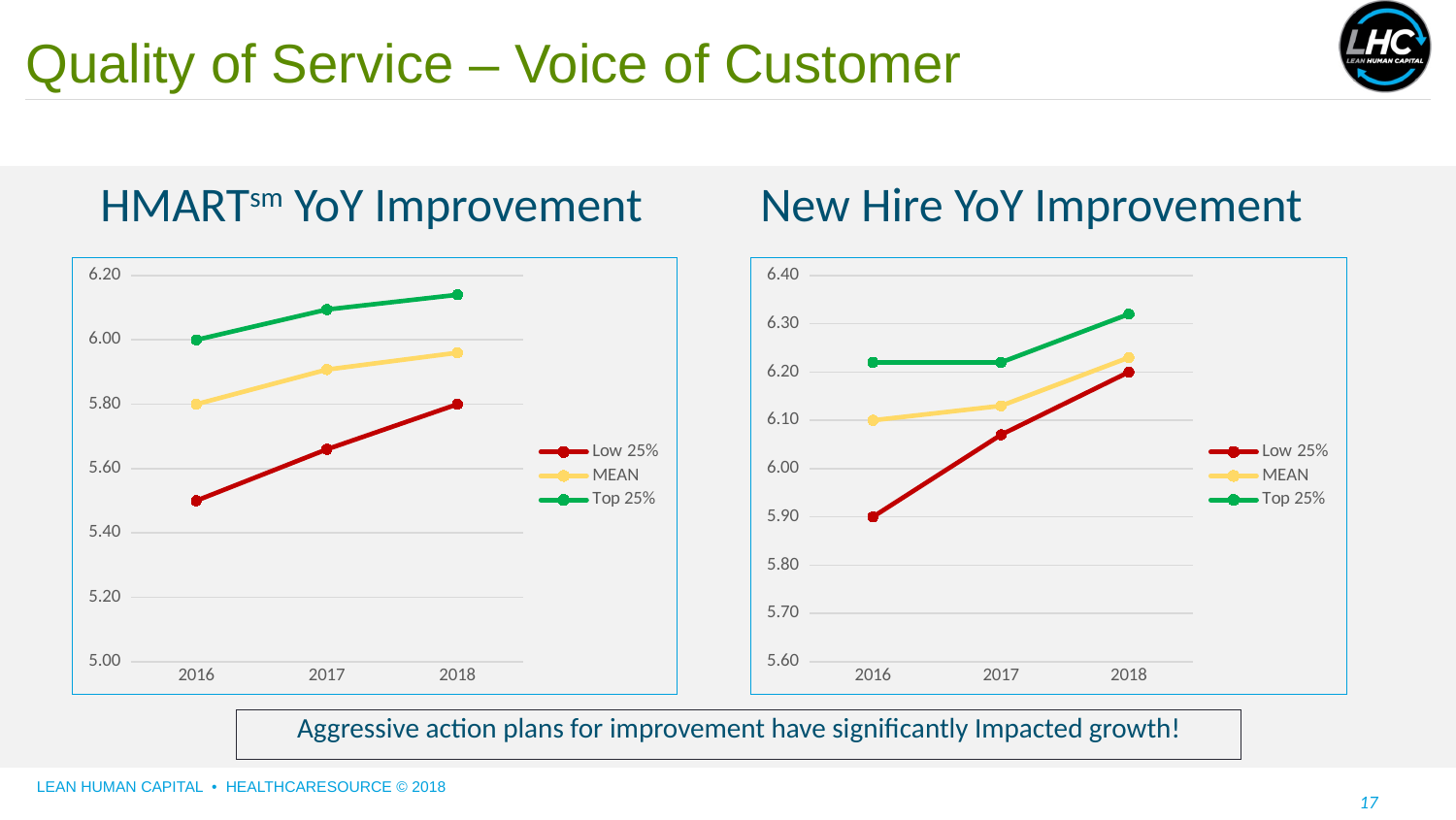
In the New Hire YoY Improvement chart, what is the Low 25% value for 2016? 5.90 In the New Hire YoY Improvement chart, what is the MEAN value for 2016? 6.10 How many series does the legend of the New Hire YoY Improvement chart list? 3 In the HMART YoY Improvement chart, does the Low 25% series rise or fall from 2016 to 2018? rise In the HMART YoY Improvement chart, which series is shown in red? Low 25% In the New Hire YoY Improvement chart, is the Top 25% value for 2018 greater or less than 6.30? greater How many years are shown on the x axis of the HMART YoY Improvement chart? 3 In the HMART YoY Improvement chart, what is the Low 25% value for 2018? 5.80 In the HMART YoY Improvement chart, is the Low 25% value for 2016 greater or less than 5.60? less In the New Hire YoY Improvement chart, which series has the highest value in 2018? Top 25% What kind of chart is the HMART YoY Improvement chart? line chart In the HMART YoY Improvement chart, what is the Top 25% value for 2016? 6.00